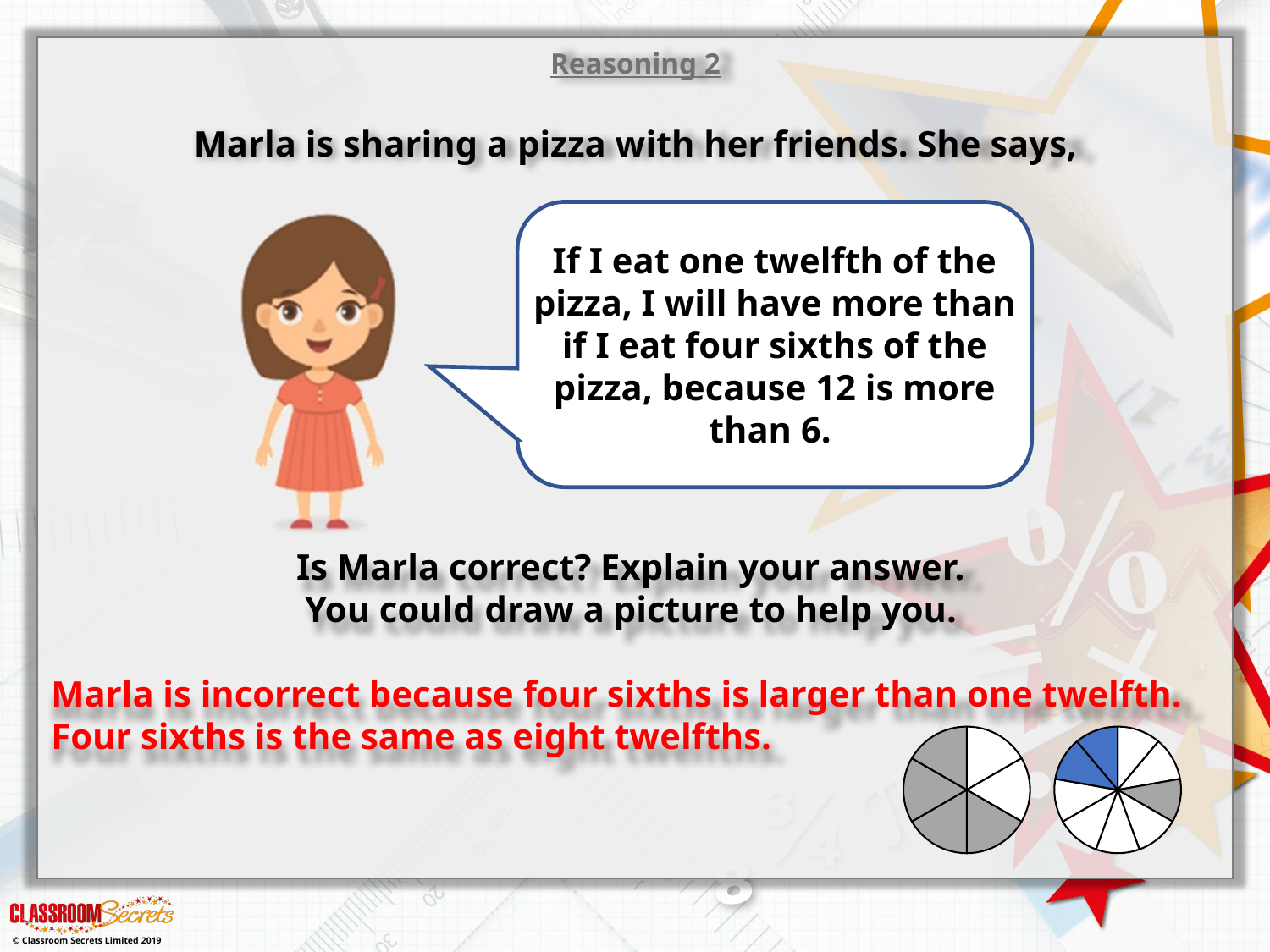
Which pie chart is divided into more sectors, the left one or the right one? the right one According to the slide, four sixths is the same as how many twelfths? eight twelfths What kind of chart are the two circular diagrams at the bottom right of the slide? pie chart What fraction of the left pie chart is shaded grey? four sixths How many equal sectors is the left pie chart divided into? 6 How many sectors of the left pie chart are shaded grey? 4 How many sectors of the right pie chart are shaded blue? 1 What fraction of the right pie chart is shaded blue? one twelfth According to the slide, which is larger: four sixths or one twelfth of the pizza? four sixths What colour is the single highlighted sector in the right pie chart? blue